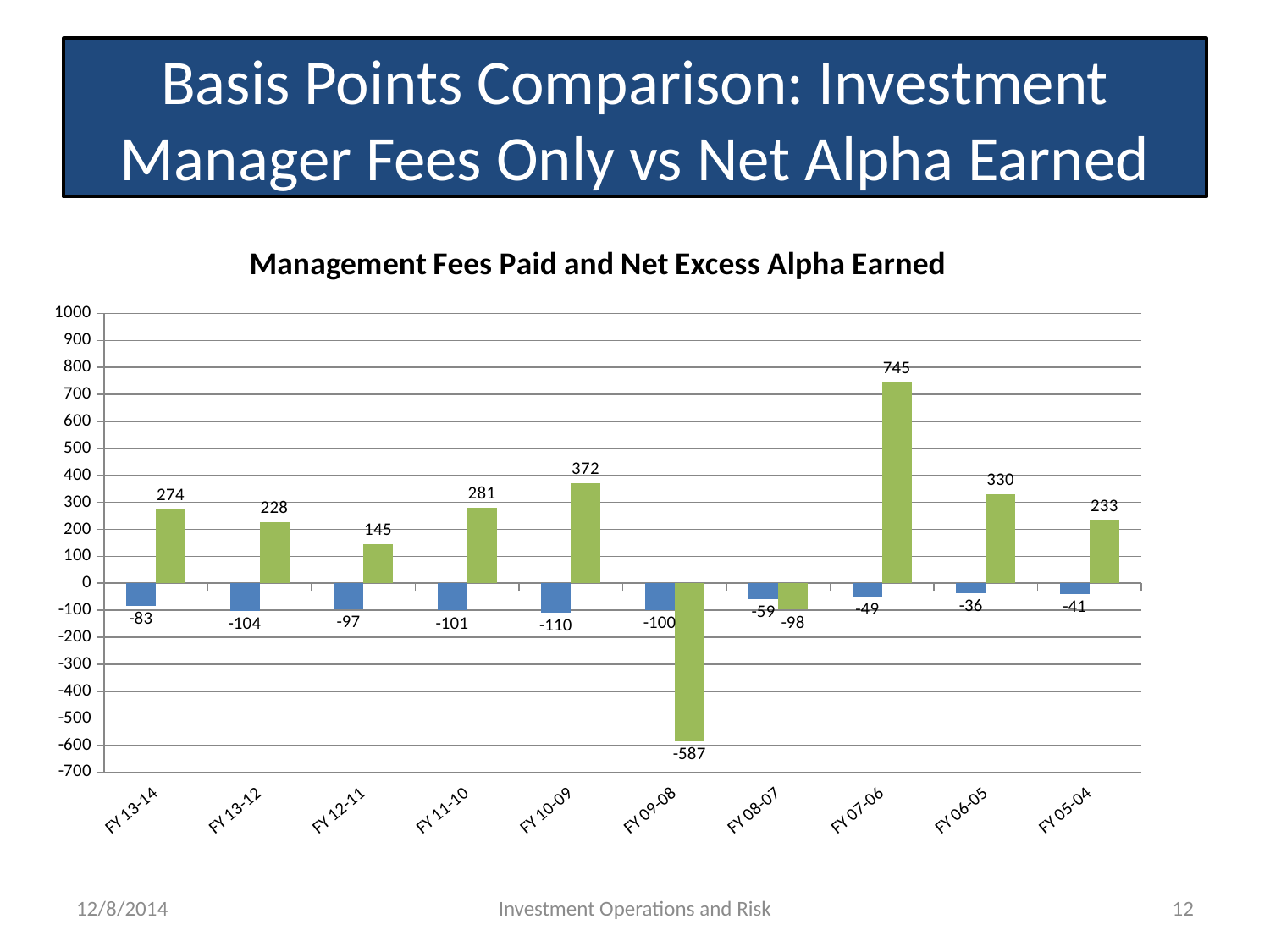
What is the title of the chart? Management Fees Paid and Net Excess Alpha Earned Which is larger, the green bar for FY 13-14 or the green bar for FY 05-04? FY 13-14 Which fiscal year has the lowest green bar? FY 09-08 What is the value of the blue bar for FY 10-09? -110 What is the difference between the green bar values for FY 10-09 and FY 11-10? 91 How many fiscal years are shown on the x axis? 10 What type of chart is shown on the slide? Bar chart What is the value of the green bar for FY 09-08? -587 Which fiscal year has the highest green bar? FY 07-06 What is the value of the blue bar for FY 06-05? -36 Which fiscal year has the lowest blue bar value? FY 10-09 What is the value of the green bar for FY 07-06? 745